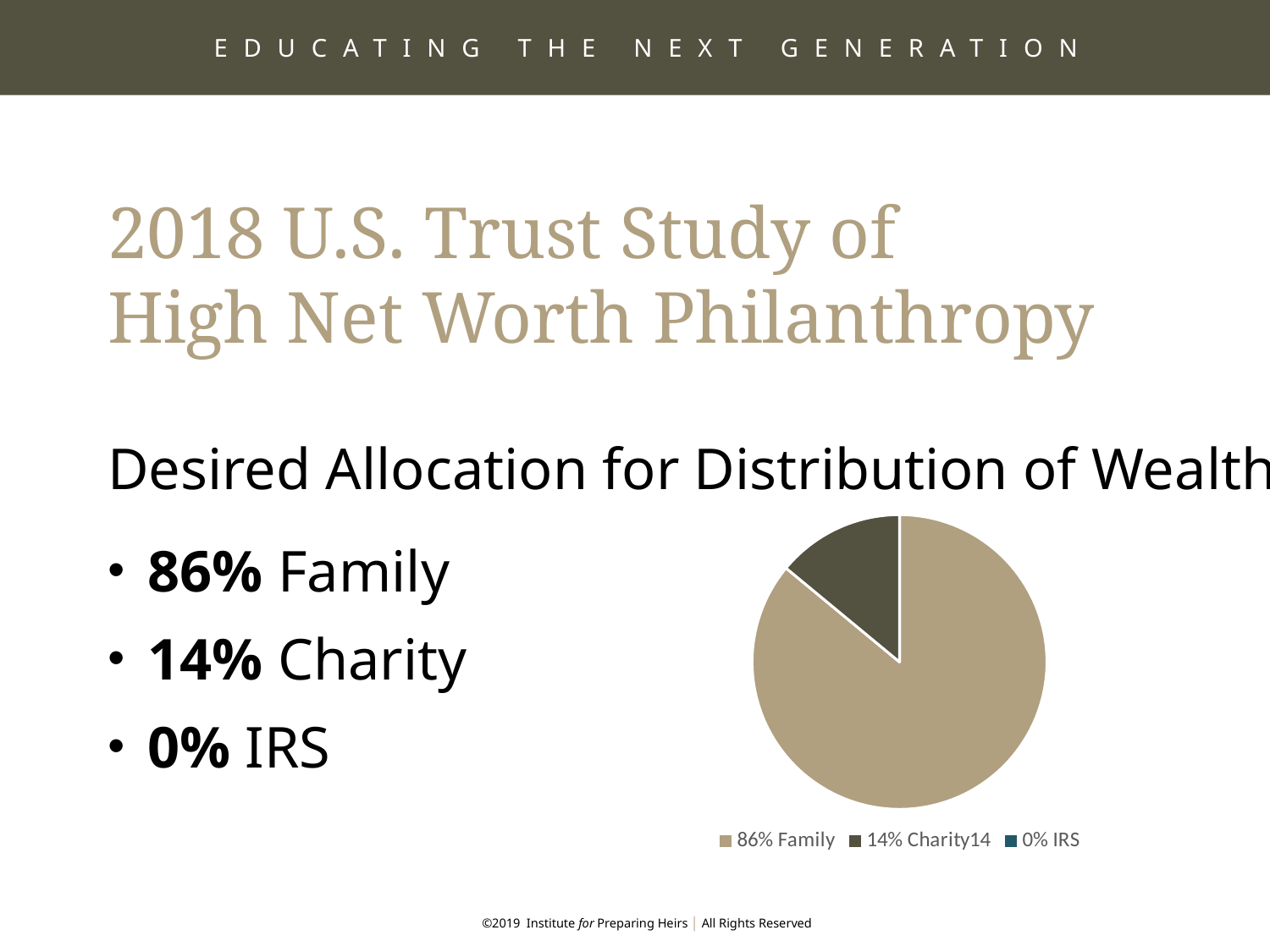
What is the heading above the pie chart? Desired Allocation for Distribution of Wealth Which category has the largest slice of the pie? Family Which category has the smallest slice of the pie? IRS What share of the pie does Charity represent? 14% What is the legend label for the darker slice of the pie? 14% Charity14 How many categories does the pie chart's legend list? 3 What share of the pie does Family represent? 86% What is the difference between the Family share and the Charity share? 72% What kind of chart is shown on the slide? pie chart Which is larger, the Family share or the Charity share? Family What share of the pie does IRS represent? 0% Is the value for Family greater or less than 50%? greater